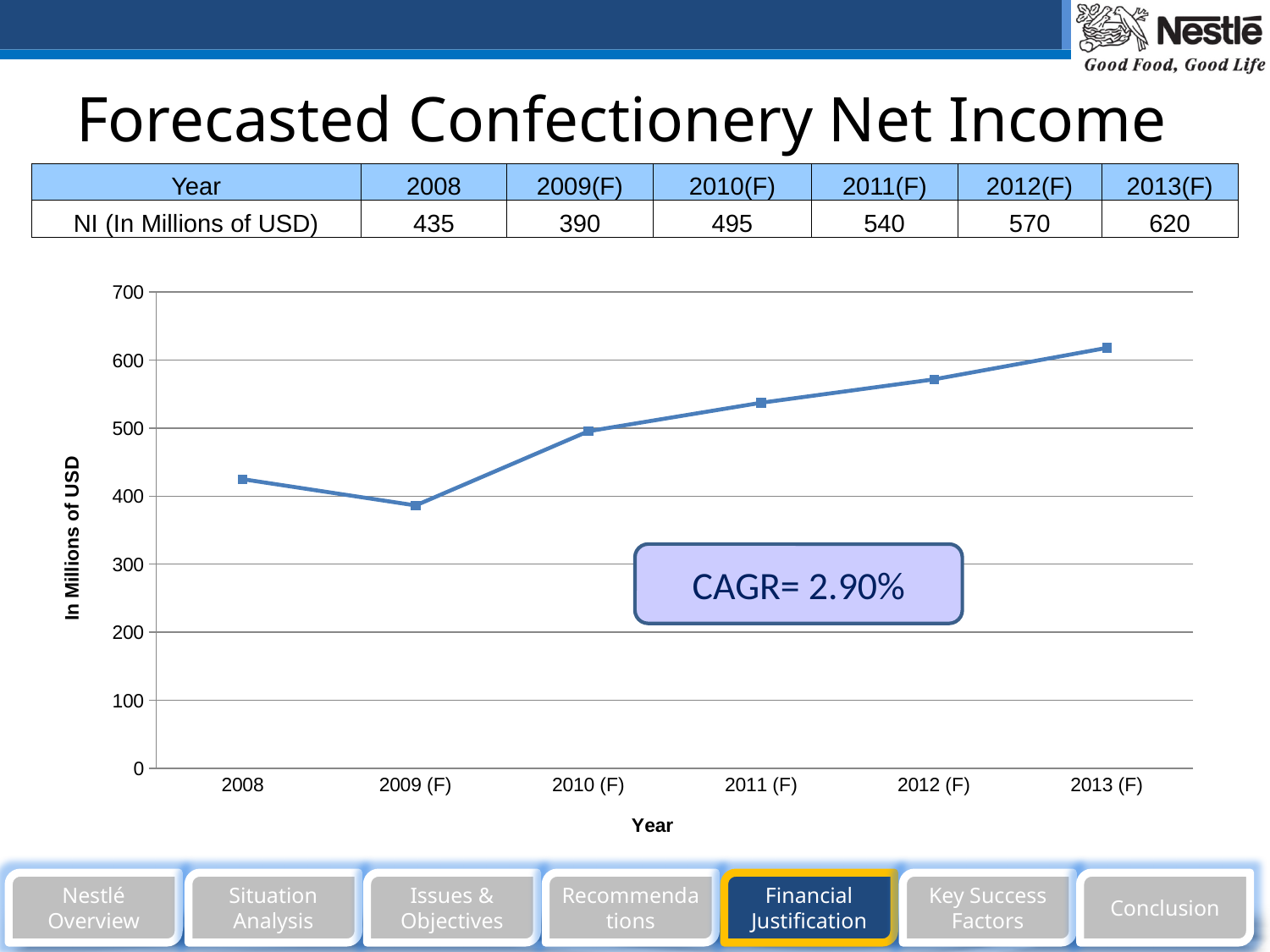
What is the net income for 2013 (F)? 620 Which year has the lowest net income on the chart? 2009 (F) What is the net income for 2011 (F)? 540 What is the net income for 2010 (F)? 495 What kind of chart is shown on the slide? line chart Do the values rise or fall from 2009 (F) to 2013 (F)? rise What is the difference between the net income for 2013 (F) and 2009 (F)? 230 How many years are plotted on the chart? 6 What is the CAGR shown in the box on the chart? 2.90% Is the value for 2008 greater or less than 400? greater Which is larger, the net income for 2011 (F) or 2012 (F)? 2012 (F) Which year has the highest net income on the chart? 2013 (F)